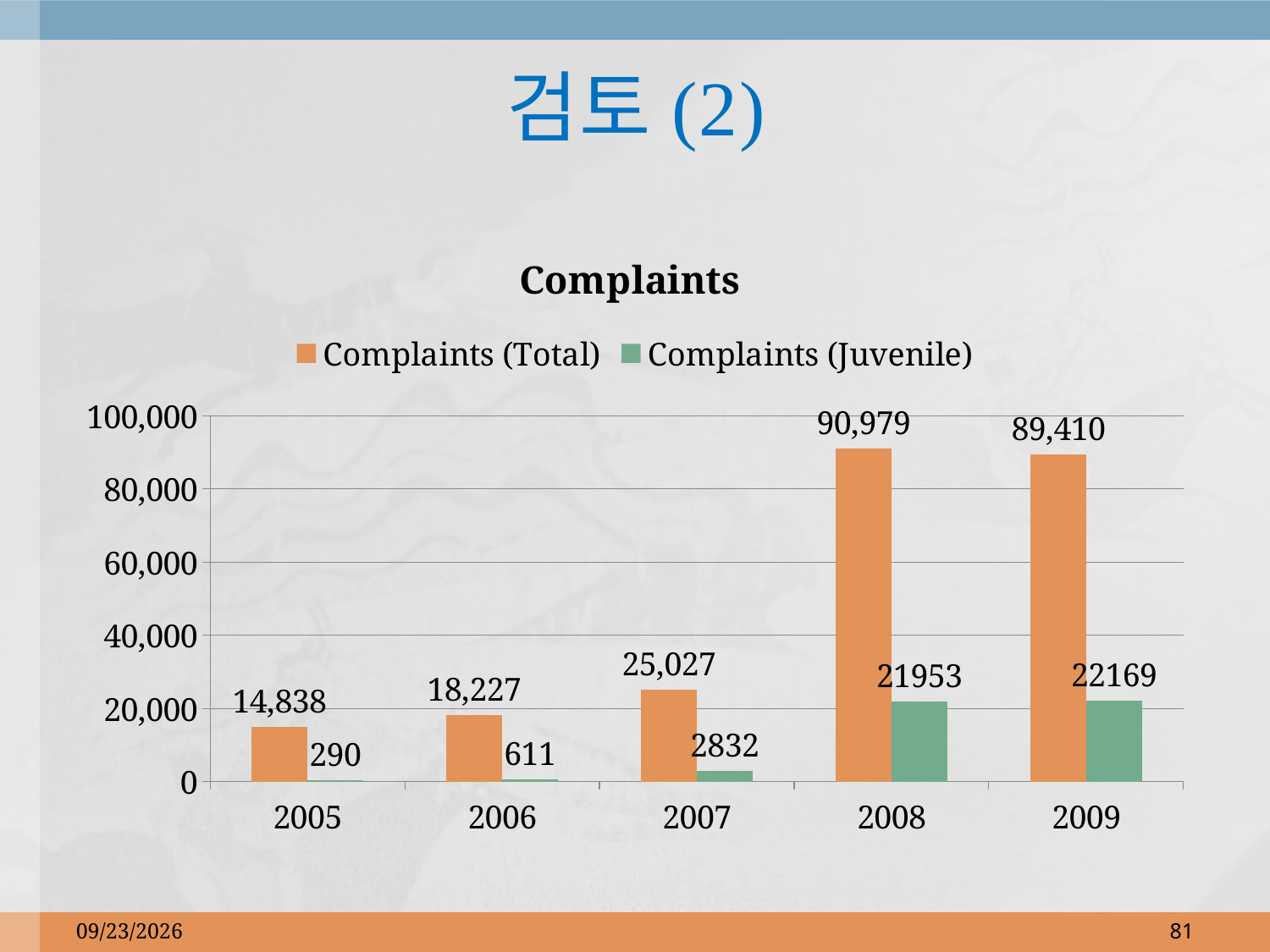
What kind of chart is shown on the slide? bar chart What is the title of the chart? Complaints Which is larger: Complaints (Total) in 2006 or in 2007? 2007 Which year has the lowest value for Complaints (Juvenile)? 2005 How many series does the legend list? 2 What is the value of Complaints (Total) for 2008? 90,979 What is the value of Complaints (Total) for 2005? 14,838 Is the value for Complaints (Total) in 2009 greater or less than 80,000? greater What is the difference between Complaints (Total) in 2008 and 2009? 1,569 What is the value of Complaints (Juvenile) for 2007? 2832 How many years are shown on the x axis? 5 Which year has the highest value for Complaints (Total)? 2008